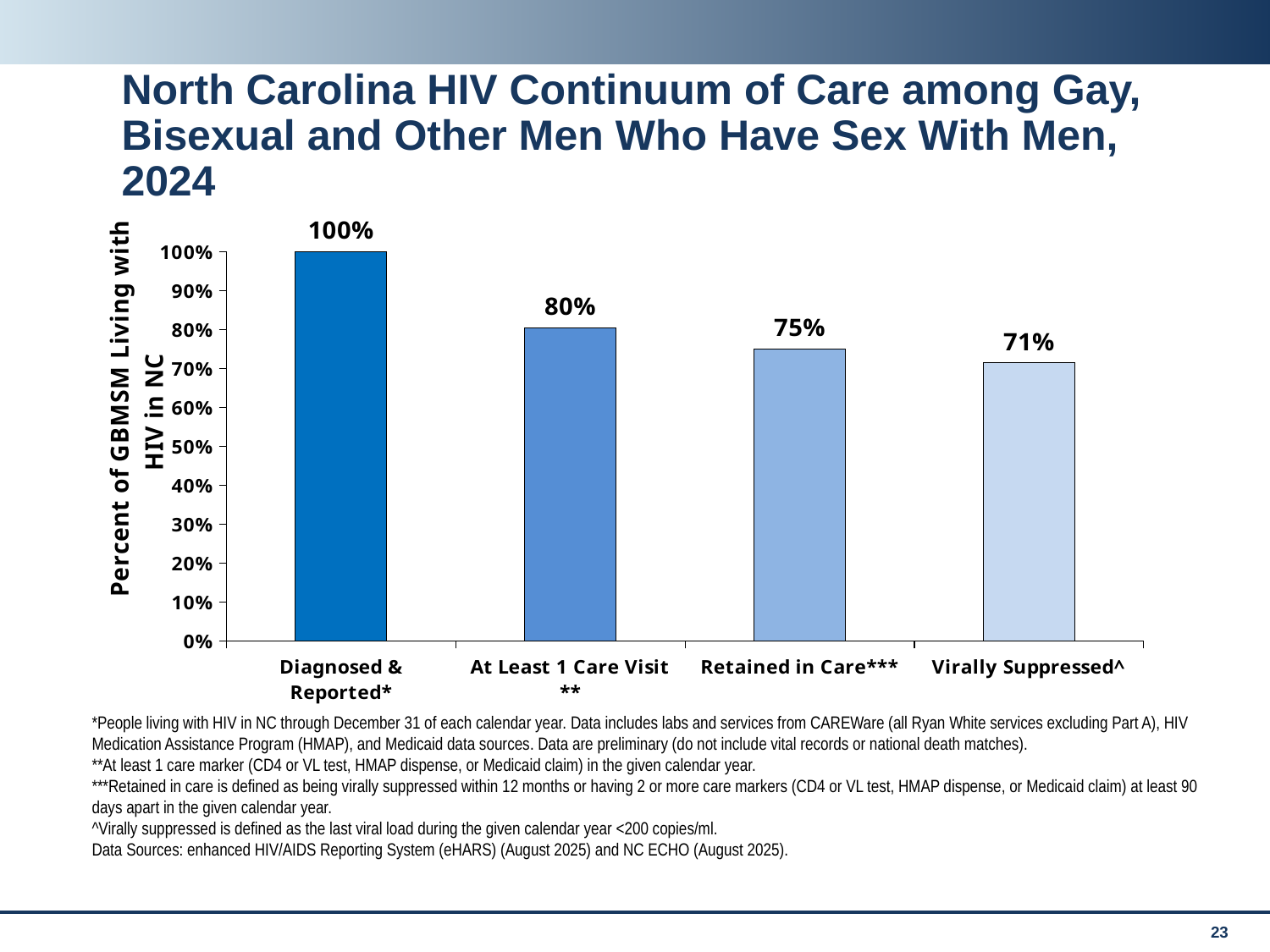
What percentage is shown for Diagnosed & Reported*? 100% Which category has the lowest value? Virally Suppressed^ Do the values rise or fall from left to right along the x axis? Fall What percentage is shown for Virally Suppressed^? 71% What is the difference in percentage points between At Least 1 Care Visit** and Virally Suppressed^? 9 percentage points Which is larger, the value for Retained in Care*** or the value for Virally Suppressed^? Retained in Care*** Which category has the highest value? Diagnosed & Reported* What percentage is shown for At Least 1 Care Visit**? 80% What is the difference in percentage points between Diagnosed & Reported* and Retained in Care***? 25 percentage points What kind of chart is shown on the slide? Bar chart What percentage is shown for Retained in Care***? 75% How many categories are shown on the x axis? 4